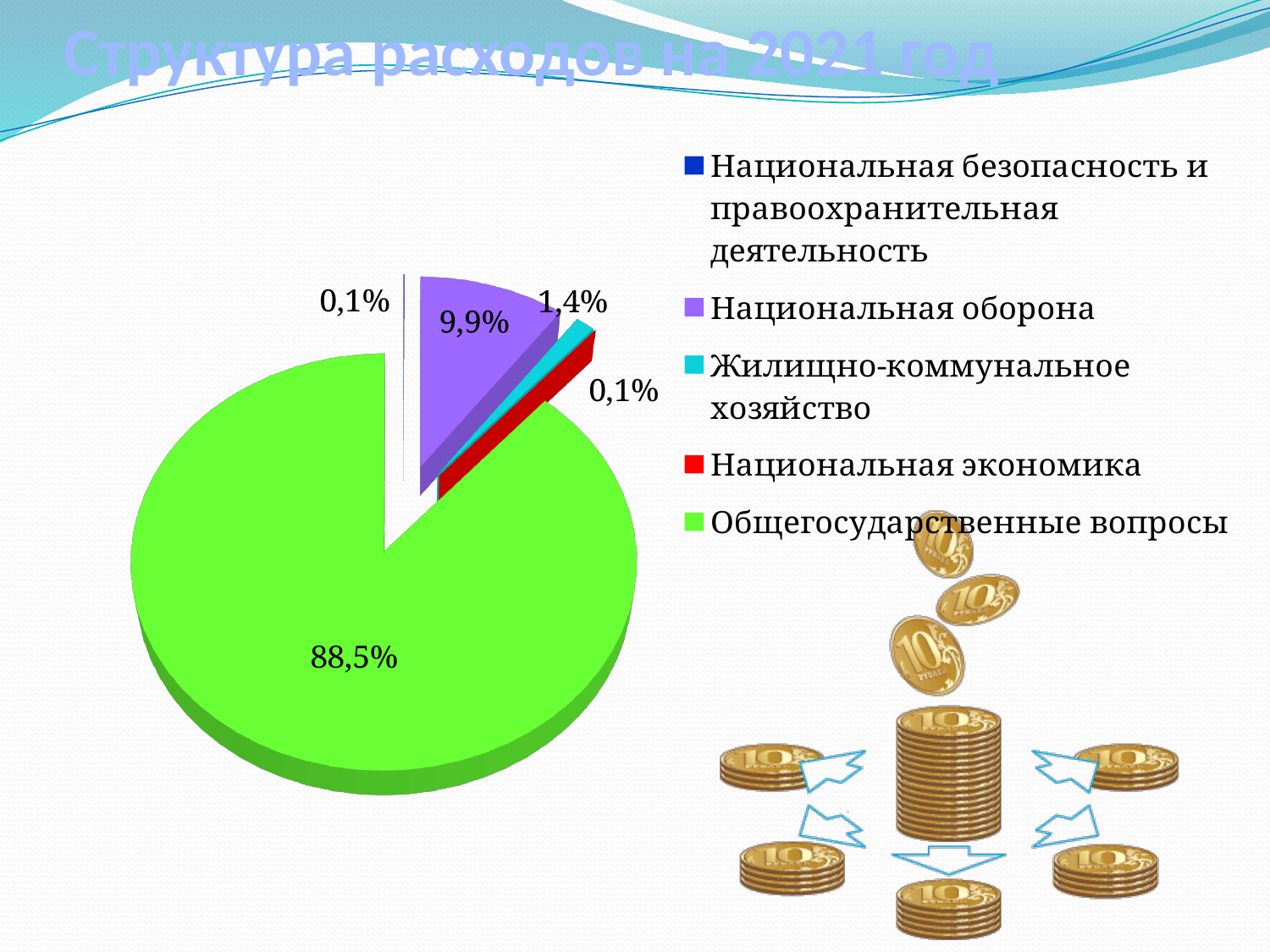
What share of the pie is labelled for Общегосударственные вопросы? 88,5% What colour is the slice for Общегосударственные вопросы? green Which is larger, the slice for Национальная оборона or the slice for Жилищно-коммунальное хозяйство? Национальная оборона What share of the pie is labelled for Жилищно-коммунальное хозяйство? 1,4% What share of the pie is labelled for Национальная экономика? 0,1% Which category has the largest slice of the pie? Общегосударственные вопросы What is the difference between the share for Общегосударственные вопросы and the share for Национальная оборона? 78,6% What kind of chart is shown on the slide? pie chart What is the title of the chart on the slide? Структура расходов на 2021 год What is the difference between the share for Национальная оборона and the share for Жилищно-коммунальное хозяйство? 8,5% How many categories does the legend of the pie chart list? 5